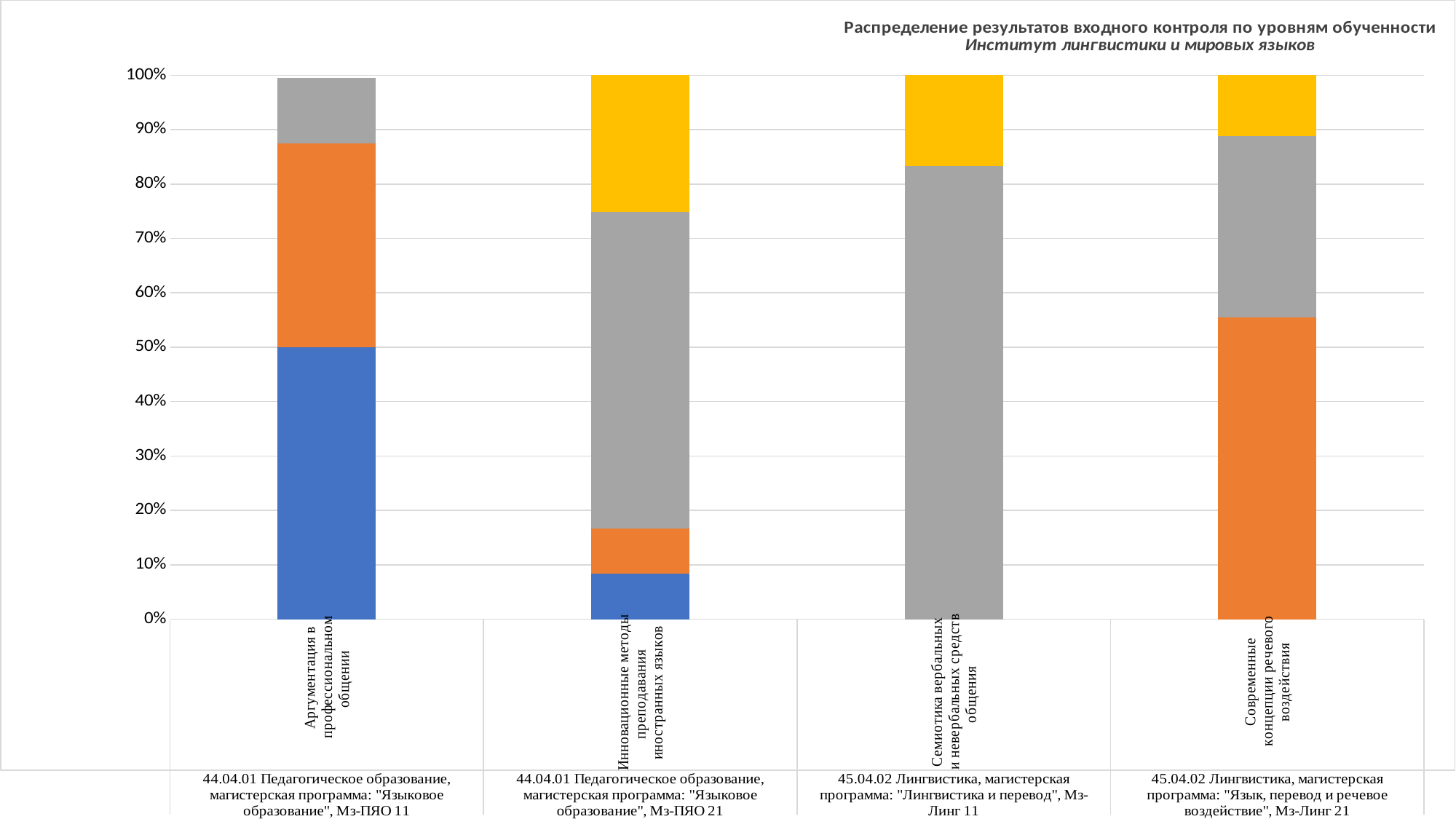
Is the grey segment for "Семиотика вербальных и невербальных средств общения" greater or less than 80%? greater Is the orange segment for "Современные концепции речевого воздействия" greater or less than 50%? greater How many categories (bars) are shown on the x axis? 4 Is the blue segment for "Инновационные методы преподавания иностранных языков" greater or less than 10%? less Which bar has the larger yellow segment: "Инновационные методы преподавания иностранных языков" or "Семиотика вербальных и невербальных средств общения"? Инновационные методы преподавания иностранных языков What kind of chart is shown on the slide? Stacked bar chart How many coloured segments make up the bar for "Семиотика вербальных и невербальных средств общения"? 2 Which category's bar consists only of grey and yellow segments? Семиотика вербальных и невербальных средств общения Which bar has the larger blue segment: "Аргументация в профессиональном общении" or "Инновационные методы преподавания иностранных языков"? Аргументация в профессиональном общении Which institute is named in the chart's subtitle? Институт лингвистики и мировых языков What is the title of the chart? Распределение результатов входного контроля по уровням обученности